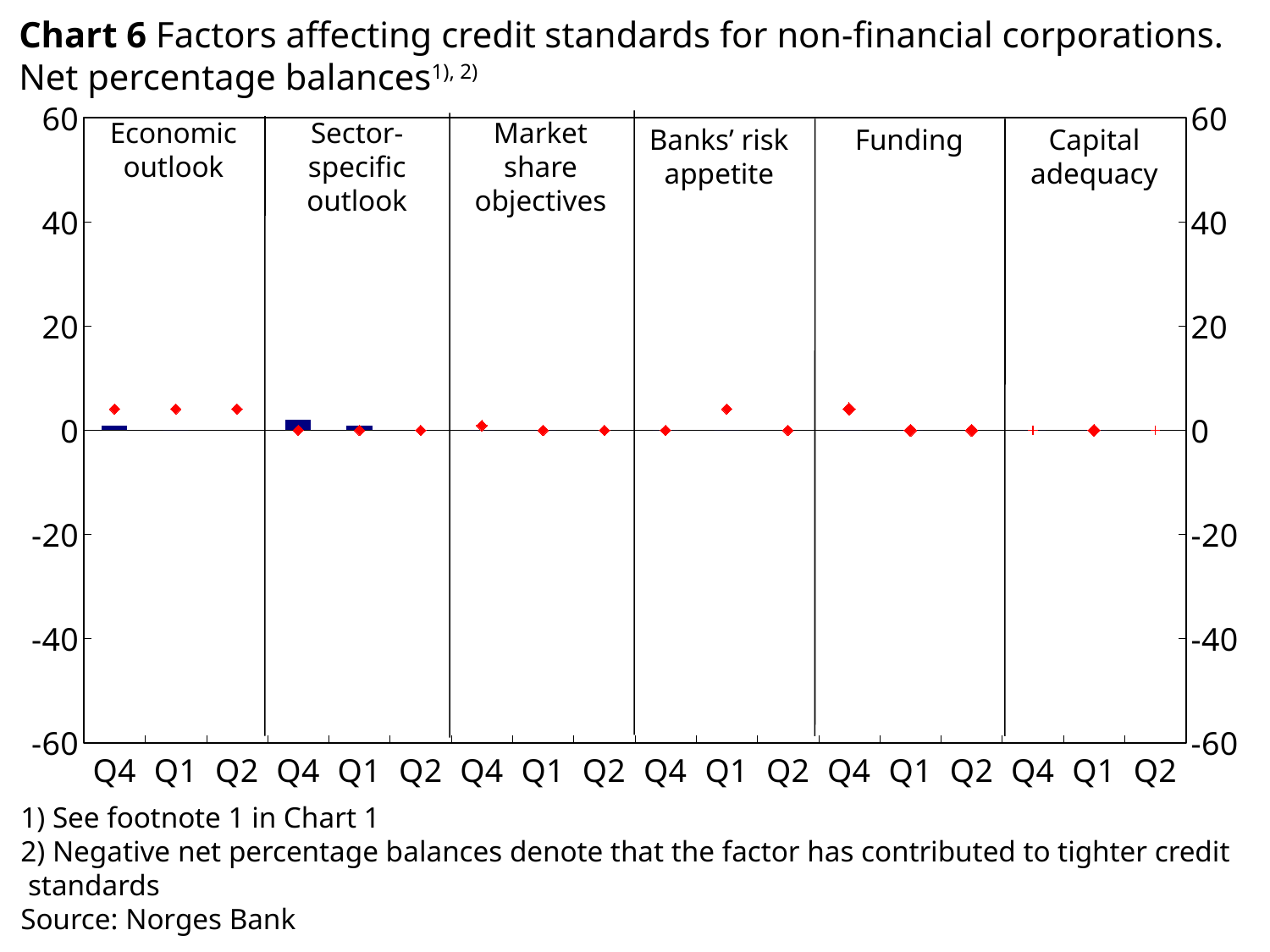
What kind of chart is shown on the slide? Combination bar and line chart (blue bars with red diamond markers) Is the value for Economic outlook in Q4 greater or less than 20? less Which quarters are labelled on the x axis for each factor? Q4, Q1, Q2 How many factors (panels) are shown in the chart? 6 Is the value for Capital adequacy in Q1 greater or less than 20? less How many quarters are shown on the x axis within each factor panel? 3 What is the highest value shown on the vertical axis? 60 Is the value for Funding in Q4 greater or less than 20? less In which factor panel does the tallest blue bar appear? Sector-specific outlook What is the lowest value shown on the vertical axis? -60